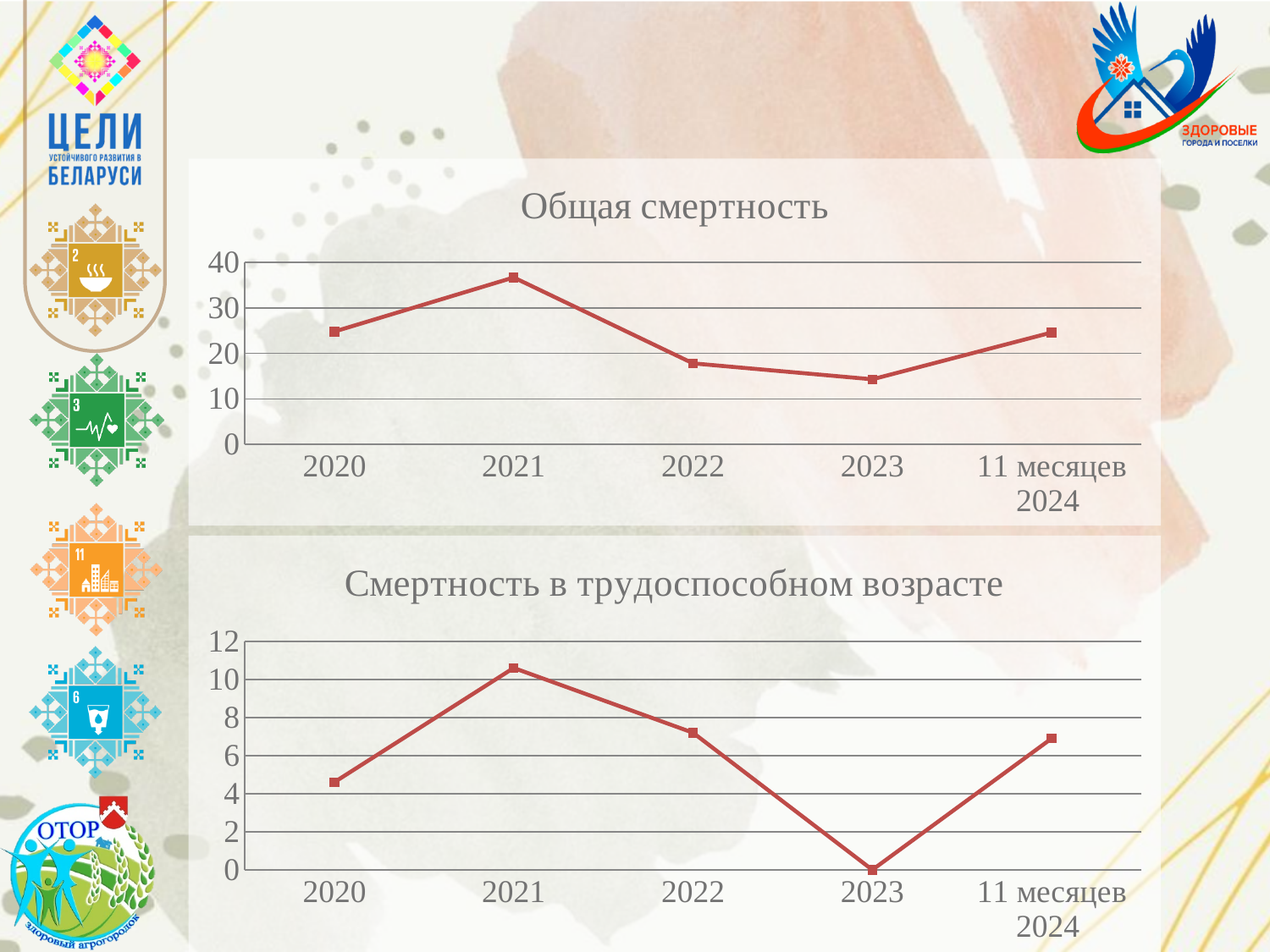
In the top chart "Общая смертность", which is larger: the value for 2020 or the value for 2022? 2020 In the top chart "Общая смертность", which category has the lowest value? 2023 In the bottom chart "Смертность в трудоспособном возрасте", does the value rise or fall from 2021 to 2023? fall In the bottom chart "Смертность в трудоспособном возрасте", which year has the highest value? 2021 In the bottom chart "Смертность в трудоспособном возрасте", is the value for 2021 greater or less than 10? greater In the bottom chart "Смертность в трудоспособном возрасте", what is the value for 2023? 0 What kind of chart is the top chart titled "Общая смертность"? line chart In the top chart "Общая смертность", is the value for 2023 greater or less than 20? less What is the title of the bottom chart on the slide? Смертность в трудоспособном возрасте In the top chart "Общая смертность", which year has the highest value? 2021 In the top chart "Общая смертность", is the value for 2021 greater or less than 30? greater How many data points are plotted in the top chart "Общая смертность"? 5